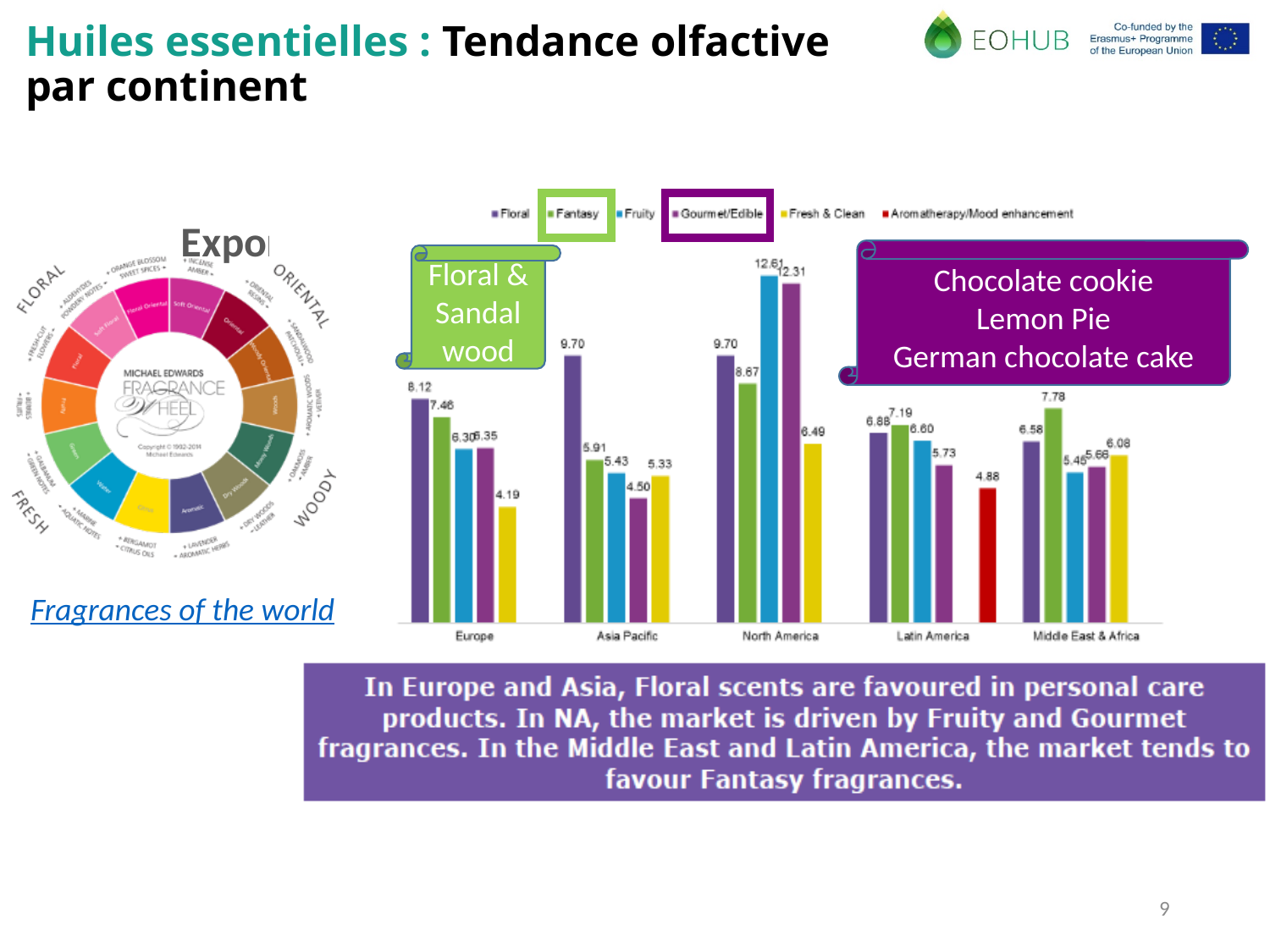
What is the Aromatherapy/Mood enhancement value for Latin America in the bar chart? 4.88 How many regions are shown along the x axis of the bar chart? 5 Which series is highlighted with a purple box in the legend of the bar chart? Gourmet/Edible What is the Fruity value for North America in the bar chart? 12.61 In the bar chart, is the Fantasy value for Latin America larger than the Floral value for Latin America? Yes, Fantasy (7.19) is larger than Floral (6.88) Which region has the highest Floral value in the bar chart? Asia Pacific and North America (9.70) What is the Floral value for Europe in the bar chart? 8.12 What is the difference between the Floral and Fresh & Clean values for Europe in the bar chart? 3.93 What is the Fantasy value for Middle East & Africa in the bar chart? 7.78 What kind of chart is shown on the right of the slide? bar chart Which series has the lowest value for Asia Pacific in the bar chart? Gourmet/Edible How many series does the legend of the bar chart list? 6